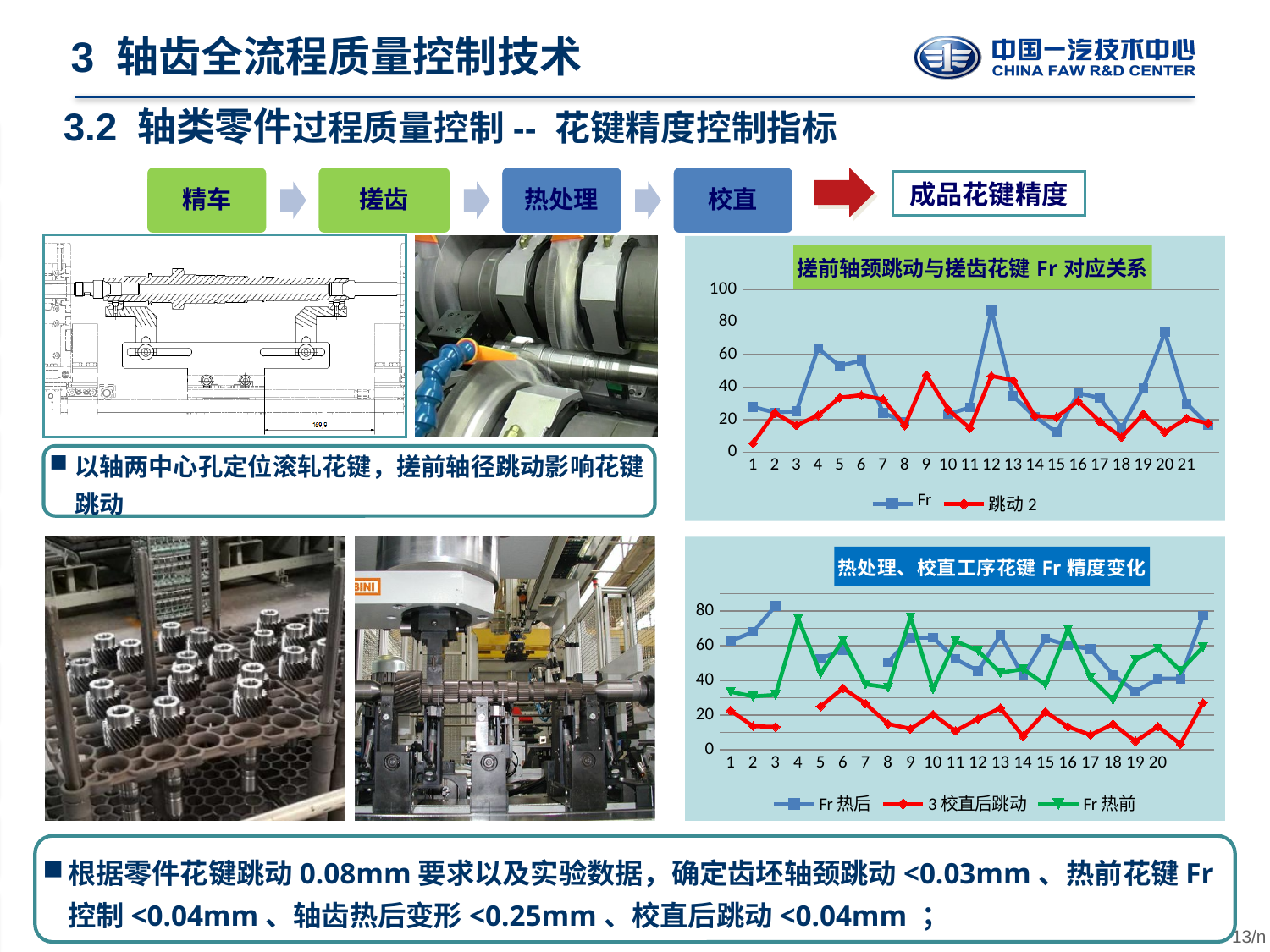
In the chart titled 搓前轴颈跳动与搓齿花键 Fr 对应关系, is the Fr value at point 15 greater or less than 20? less In the chart titled 热处理、校直工序花键 Fr 精度变化, which series is larger at point 4, Fr热前 or 3校直后跳动? Fr热前 In the chart titled 搓前轴颈跳动与搓齿花键 Fr 对应关系, at which x-axis point does the Fr series reach its highest value? 12 What kind of chart is the one titled 搓前轴颈跳动与搓齿花键 Fr 对应关系? line chart In the chart titled 搓前轴颈跳动与搓齿花键 Fr 对应关系, is the Fr value at point 12 greater or less than 80? greater In the chart titled 热处理、校直工序花键 Fr 精度变化, is the Fr热后 value at point 3 greater or less than 80? greater In the chart titled 热处理、校直工序花键 Fr 精度变化, how many points are plotted along the x axis? 22 In the chart titled 热处理、校直工序花键 Fr 精度变化, how many series does the legend list? 3 In the chart titled 搓前轴颈跳动与搓齿花键 Fr 对应关系, how many series does the legend list? 2 In the chart titled 搓前轴颈跳动与搓齿花键 Fr 对应关系, which series is larger at point 20, Fr or 跳动2? Fr In the chart titled 搓前轴颈跳动与搓齿花键 Fr 对应关系, how many points are plotted along the x axis? 22